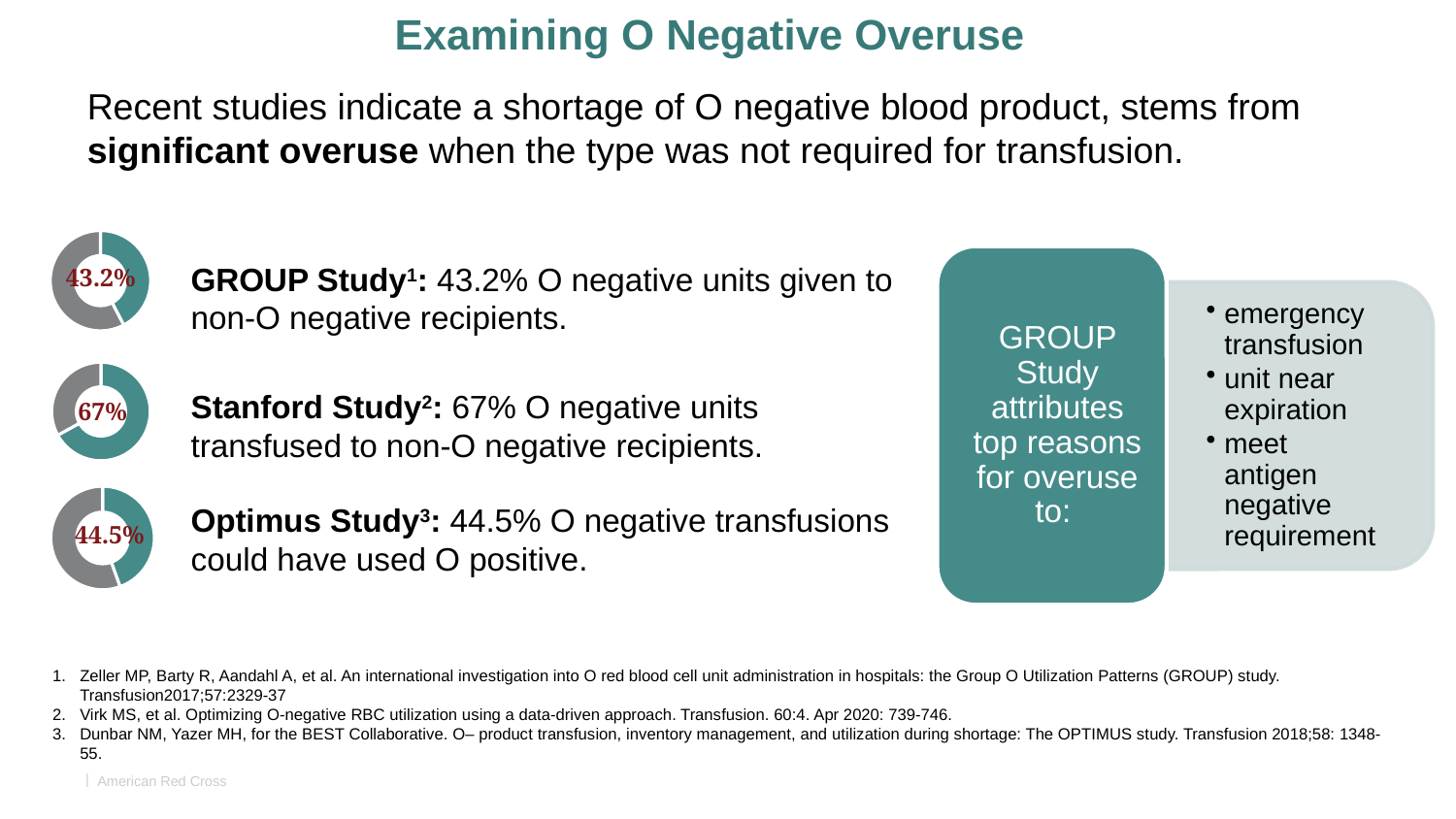
What value is printed on the top donut chart next to the GROUP Study? 43.2% Of the three donut charts on the slide, which study's chart shows the highest percentage? Stanford Study (67%) How many donut charts are shown on the slide? 3 What kind of chart is used to show the percentage for each study on the left side of the slide? Donut (pie) chart How many slices does each donut chart on the slide have? 2 What share of the middle donut chart (Stanford Study) does the highlighted teal slice represent? 67% What is the difference between the percentage shown on the Stanford Study donut chart and the GROUP Study donut chart? 23.8% Which is larger: the percentage on the Stanford Study donut chart or the percentage on the Optimus Study donut chart? Stanford Study (67%) Of the three donut charts on the slide, which study's chart shows the lowest percentage? GROUP Study (43.2%) What value is printed on the bottom donut chart next to the Optimus Study? 44.5% What value is printed on the middle donut chart next to the Stanford Study? 67% What is the difference between the percentage shown on the Optimus Study donut chart and the GROUP Study donut chart? 1.3%